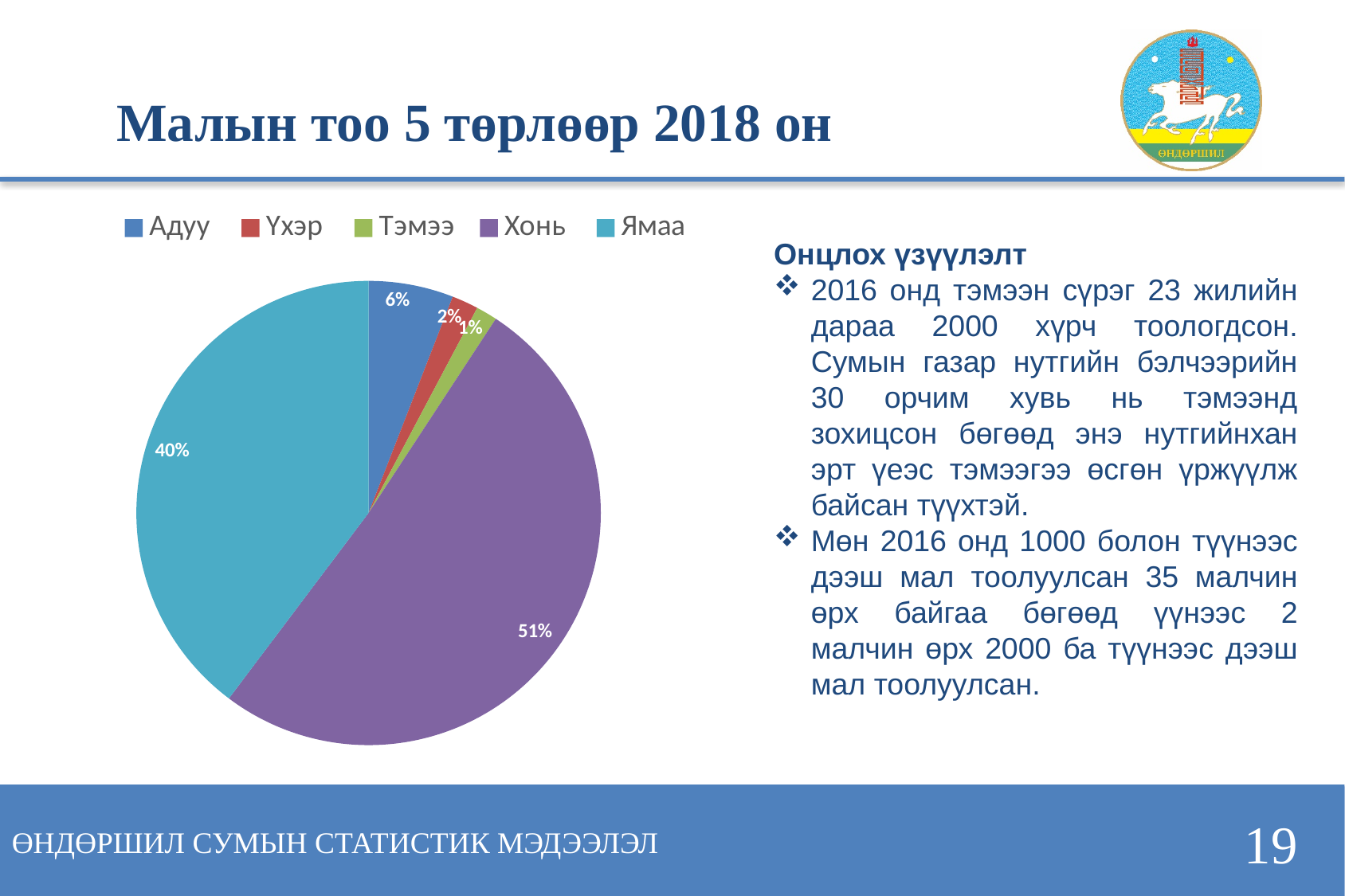
What is the title of the chart slide? Малын тоо 5 төрлөөр 2018 он What is the value shown for Үхэр? 2% What is the difference between the shares of Хонь and Ямаа? 11% What share of the pie does Ямаа account for? 40% What is the value shown for Тэмээ? 1% What kind of chart is shown on the slide? pie chart Which category has the largest slice of the pie? Хонь What share of the pie does Хонь account for? 51% What is the value shown for Адуу? 6% Which is larger, the share for Адуу or the share for Үхэр? Адуу How many categories does the legend list? 5 Which category has the smallest slice of the pie? Тэмээ